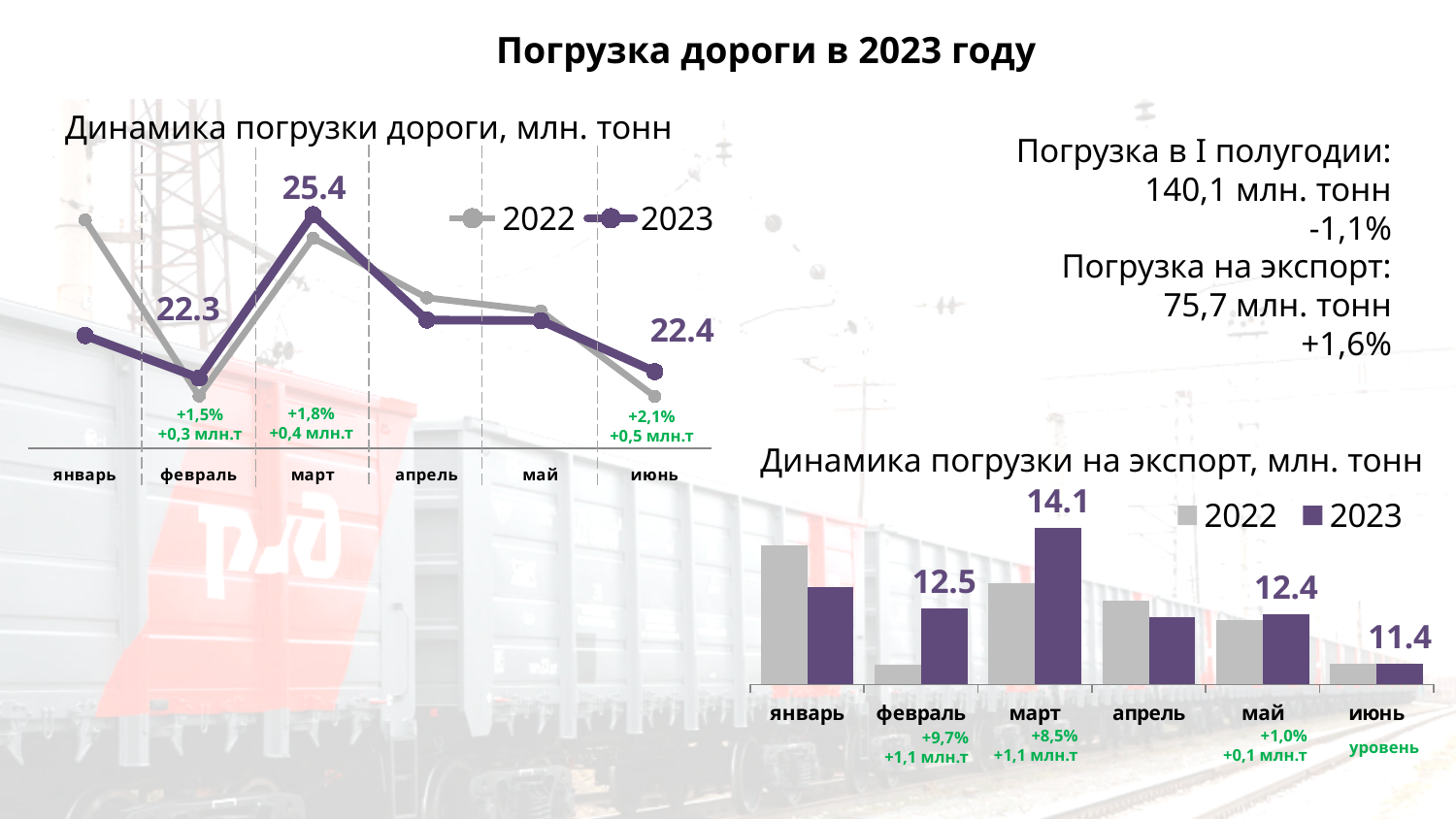
In the chart 'Динамика погрузки на экспорт, млн. тонн', which series has the larger value for январь, 2022 or 2023? 2022 In the chart 'Динамика погрузки на экспорт, млн. тонн', what is the 2023 value for июнь? 11.4 In the chart 'Динамика погрузки на экспорт, млн. тонн', what is the 2023 value for март? 14.1 In the chart 'Динамика погрузки дороги, млн. тонн', what is the difference between the 2023 values for март and февраль? 3.1 What kind of chart is 'Динамика погрузки дороги, млн. тонн'? line chart In the chart 'Динамика погрузки дороги, млн. тонн', what is the 2023 value for февраль? 22.3 In the chart 'Динамика погрузки дороги, млн. тонн', which month has the highest 2023 value? март How many series does the legend of the chart 'Динамика погрузки дороги, млн. тонн' list? 2 In the chart 'Динамика погрузки дороги, млн. тонн', what is the 2023 value for март? 25.4 In the chart 'Динамика погрузки дороги, млн. тонн', what is the 2023 value for июнь? 22.4 What kind of chart is 'Динамика погрузки на экспорт, млн. тонн'? bar chart How many months are shown on the x axis of the chart 'Динамика погрузки дороги, млн. тонн'? 6